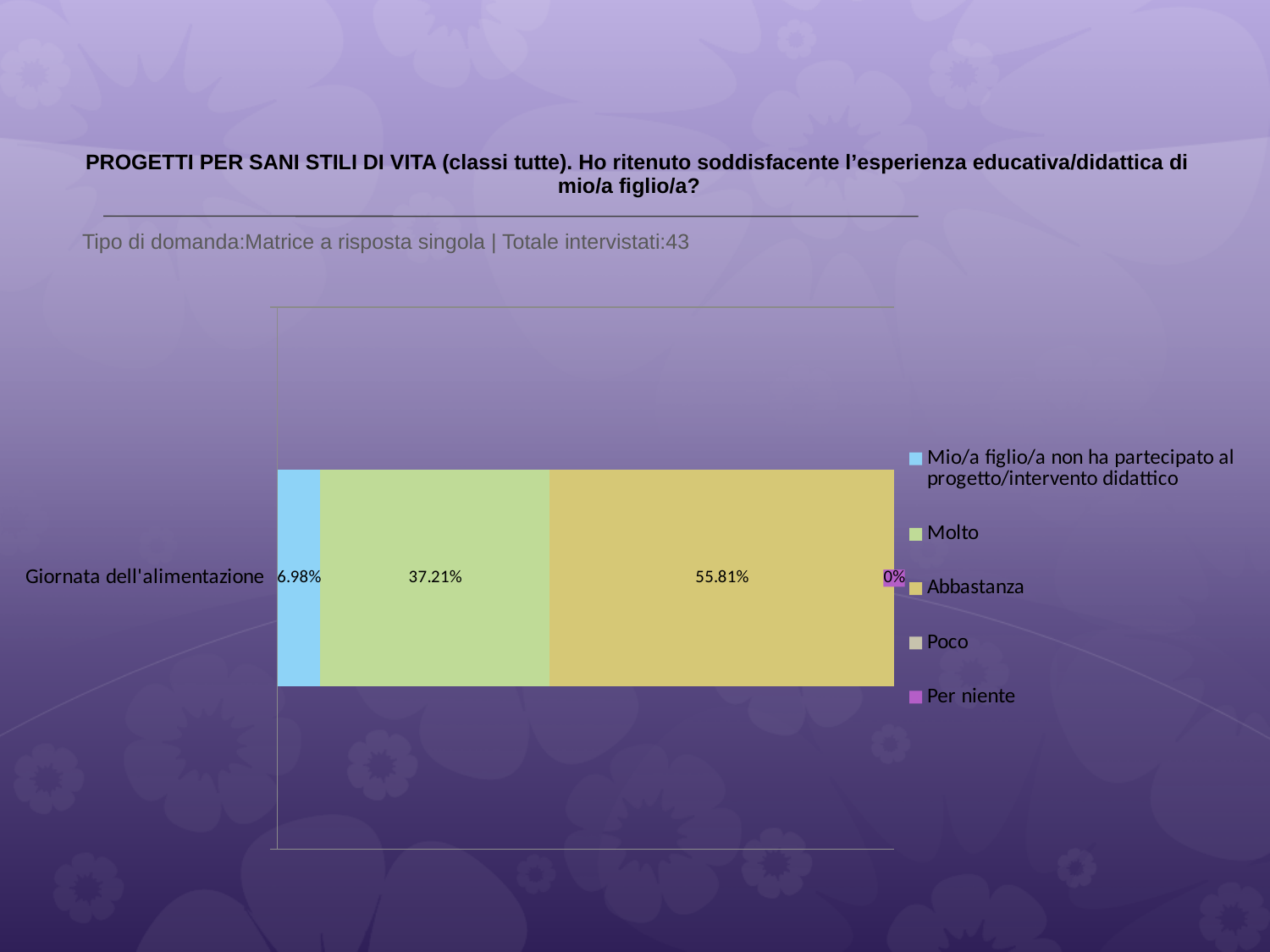
What is the difference between the Molto value and the 'non ha partecipato' value? 30.23% What is the difference between the Abbastanza and Molto values? 18.60% What is the value for Abbastanza in the Giornata dell'alimentazione bar? 55.81% Which series has the largest segment in the stacked bar? Abbastanza What is the value for 'Mio/a figlio/a non ha partecipato al progetto/intervento didattico'? 6.98% What is the label of the single category on the chart? Giornata dell'alimentazione How many categories are plotted on the chart? 1 Which is larger, Molto or Abbastanza? Abbastanza What is the value for Molto in the Giornata dell'alimentazione bar? 37.21% What is the last entry listed in the legend? Per niente How many series does the legend list? 5 What kind of chart is shown on the slide? Stacked bar chart